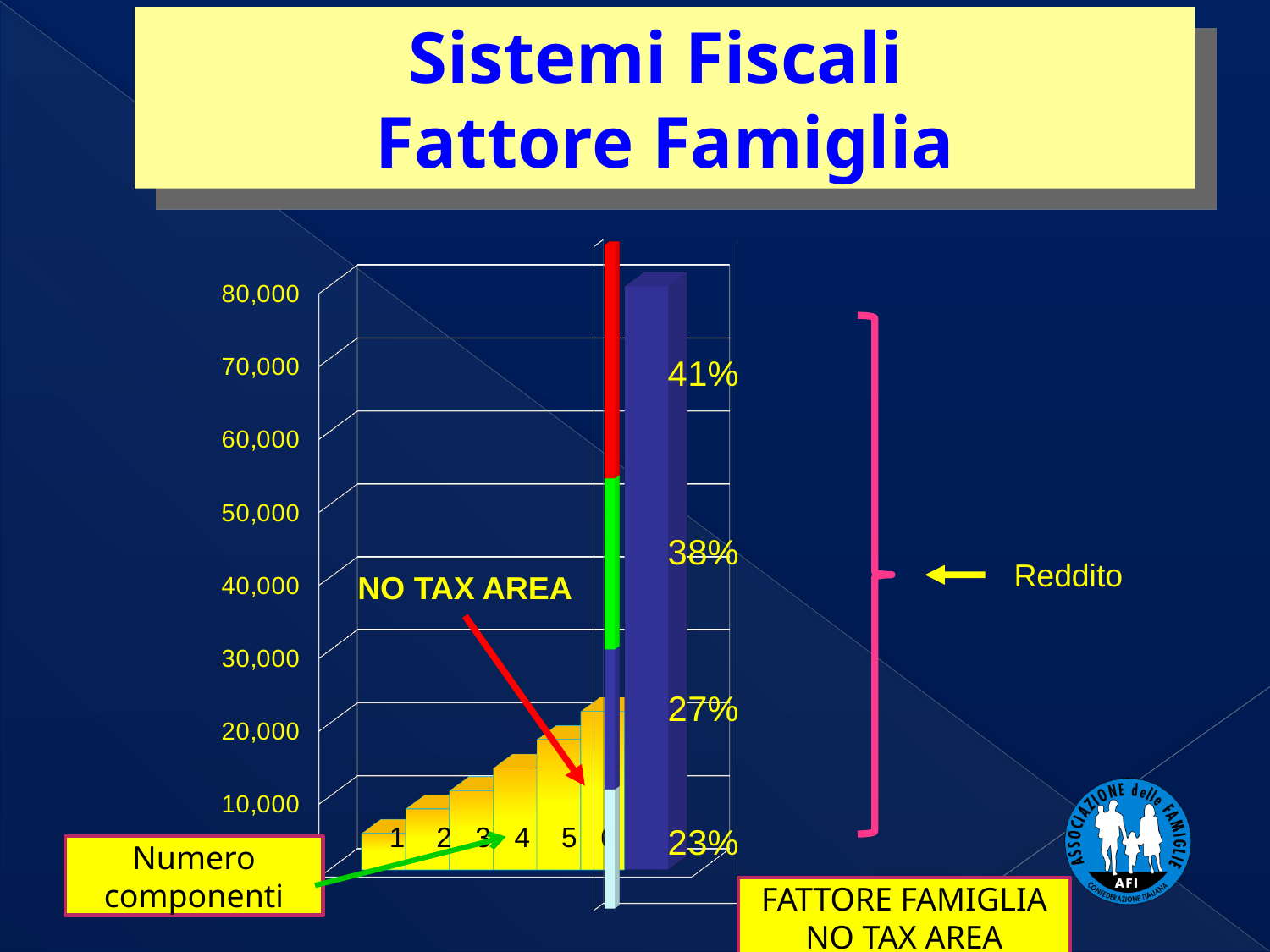
What label is written on the yellow bars area of the chart? NO TAX AREA Is the yellow bar for 1 component greater or less than 10,000? less What is the lowest percentage label shown next to the tall bar? 23% Is the yellow bar for 4 components greater or less than 10,000? greater Which number of components has the lowest yellow bar? 1 Which is larger, the yellow bar for 5 components or the yellow bar for 2 components? 5 components What is the highest percentage label shown next to the tall bar? 41% Do the yellow bars rise or fall as the number of components increases from 1 to 5? rise What kind of chart is shown on the slide? bar chart Is the tall blue bar greater or less than 70,000? greater What is the highest value shown on the vertical axis? 80,000